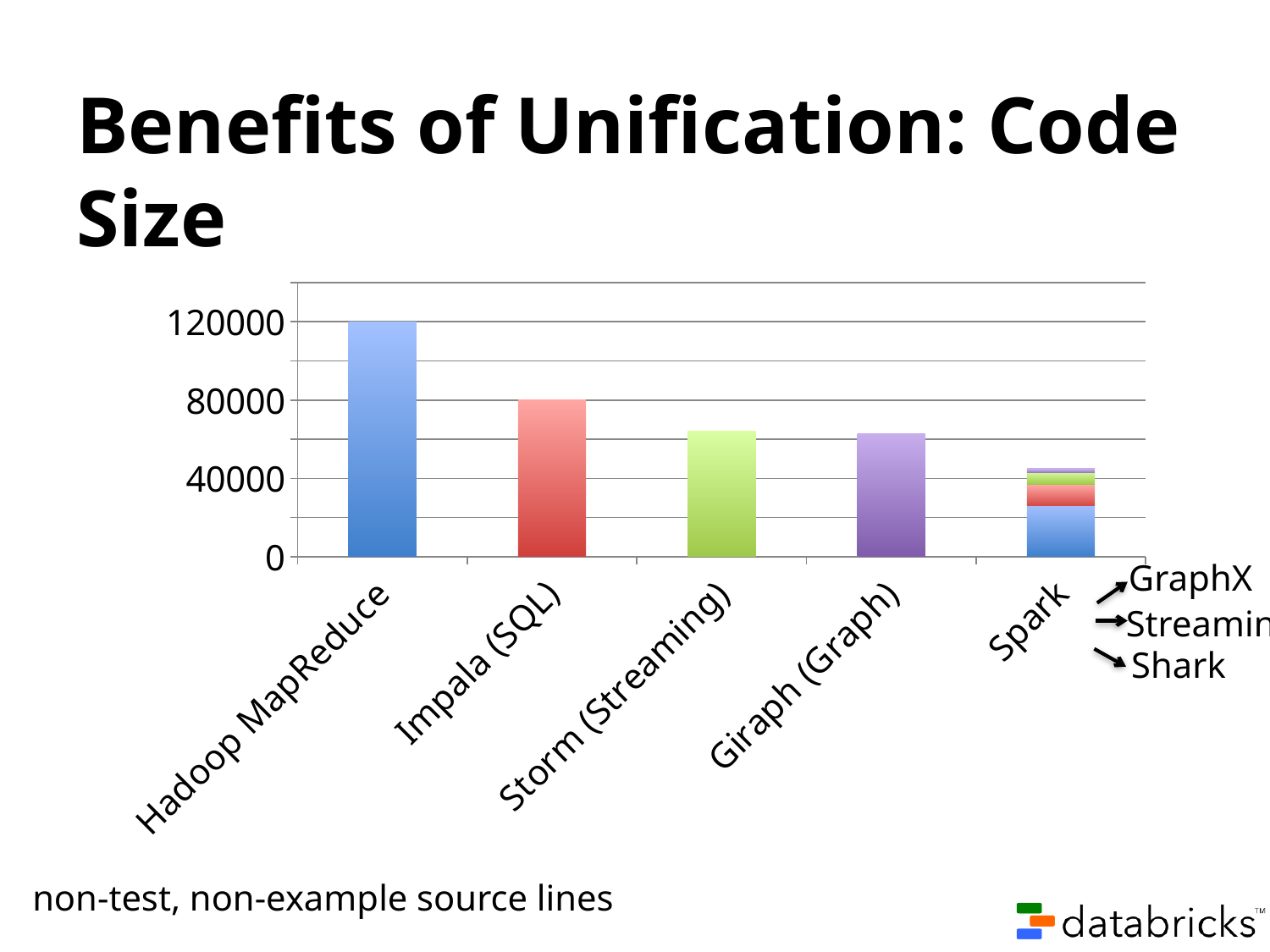
Is the value for Giraph (Graph) greater or less than 80000? less Is the value for Storm (Streaming) greater or less than 40000? greater How many categories are plotted along the x axis? 5 What is the difference between the values for Hadoop MapReduce and Impala (SQL)? 40000 What is the value for Impala (SQL)? 80000 What are the three components labelled for the Spark bar? GraphX, Streaming, Shark What is the value for Hadoop MapReduce? 120000 Is the total value for Spark greater or less than 80000? less Which category has the lowest value? Spark Which is larger, the value for Hadoop MapReduce or the value for Impala (SQL)? Hadoop MapReduce Which category has the highest value? Hadoop MapReduce What kind of chart is shown on the slide? bar chart